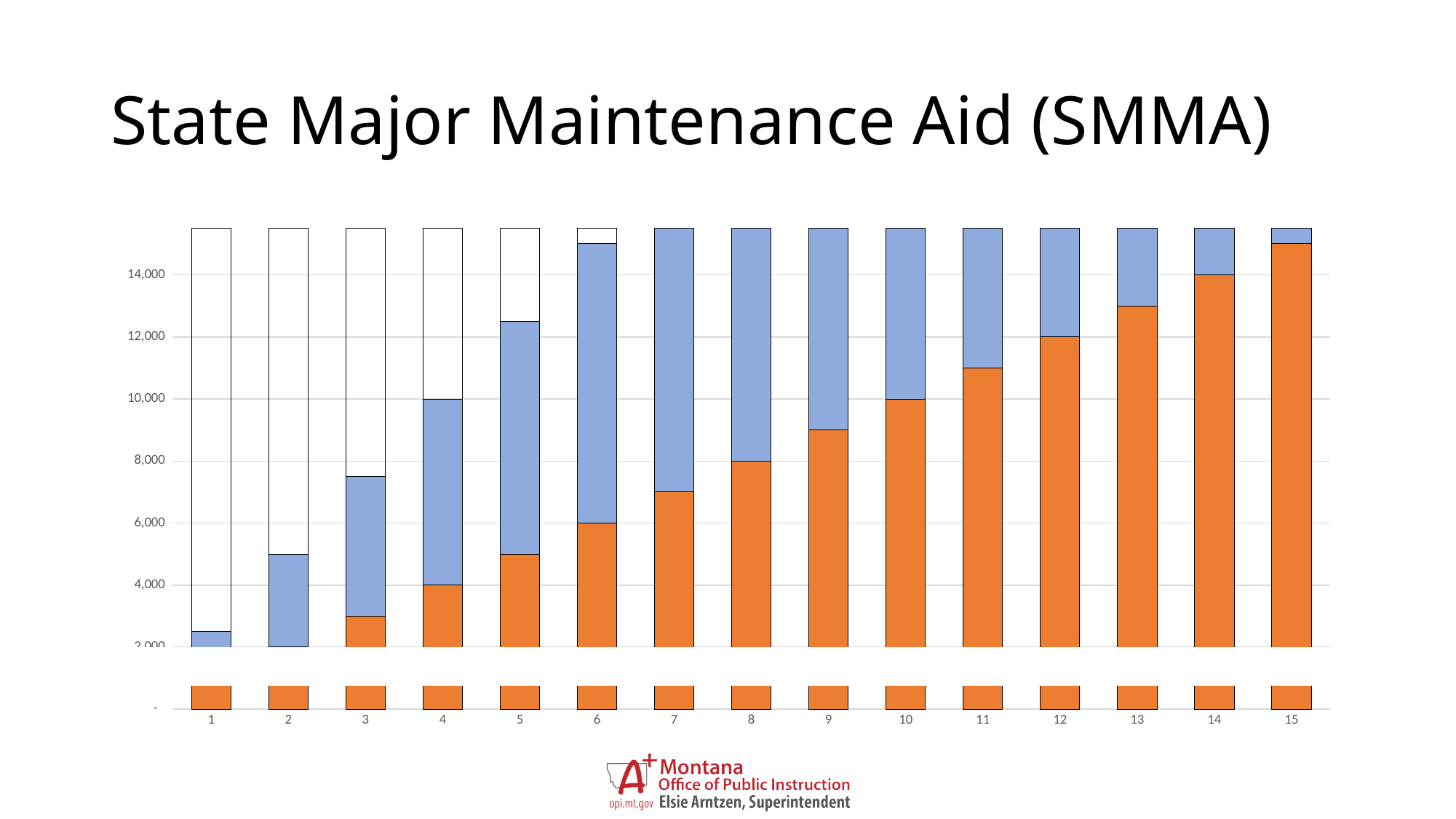
What is the value of the orange segment for category 10? 10,000 Do the orange segments rise or fall from category 1 to category 15? rise Which has the larger orange segment, category 5 or category 10? 10 What is the title of the slide? State Major Maintenance Aid (SMMA) Which category has the highest orange segment? 15 What is the difference between the orange segment for category 12 and the orange segment for category 4? 8,000 What is the value of the orange segment for category 4? 4,000 Is the orange segment for category 15 greater or less than 14,000? greater What kind of chart is shown on the slide? bar chart Is the orange segment for category 3 greater or less than 4,000? less How many categories are shown along the x axis? 15 What is the value of the orange segment for category 14? 14,000